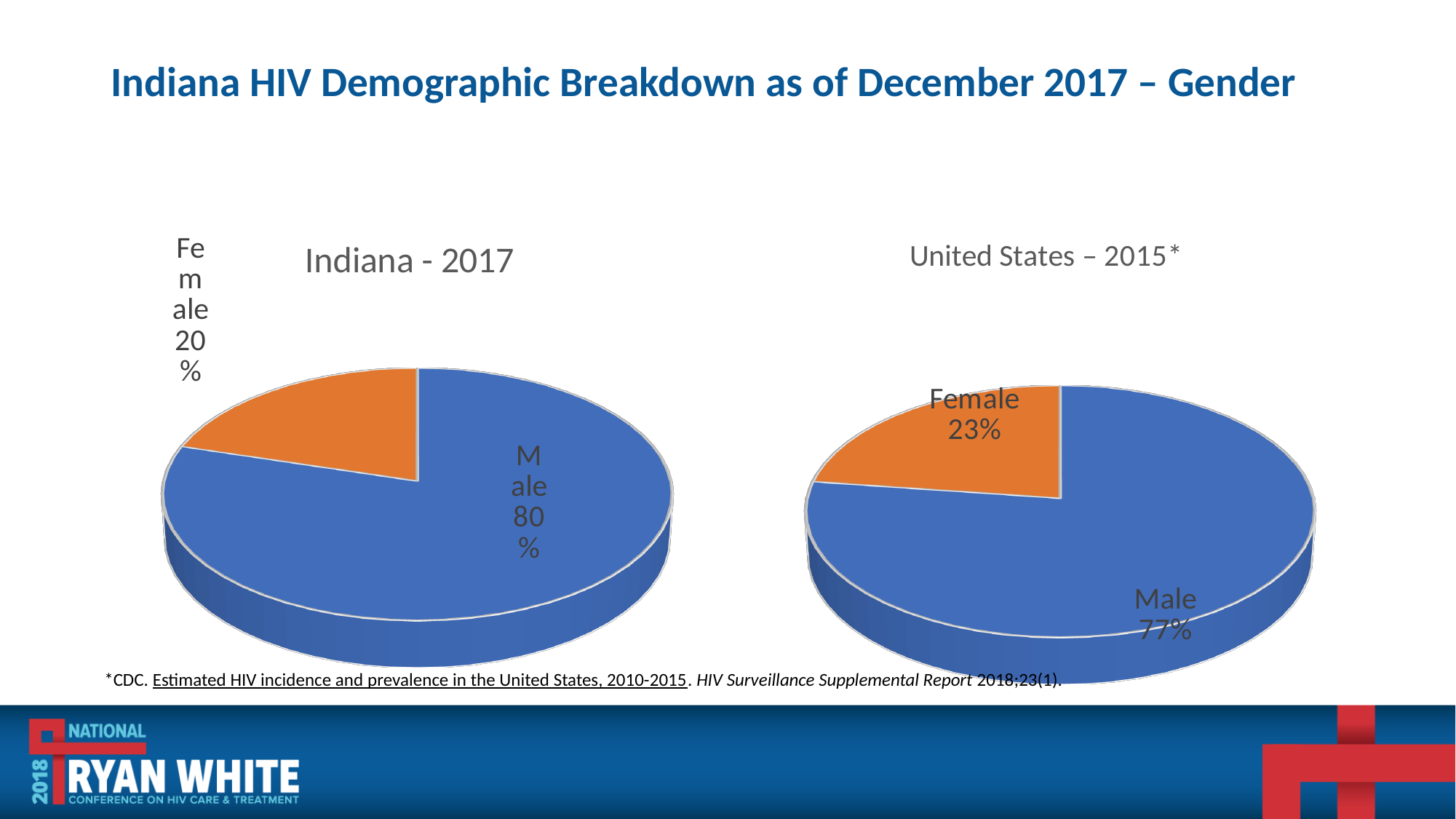
In the 'United States – 2015*' chart, which slice is the smallest? Female In the 'Indiana - 2017' chart, what colour is the Female slice? Orange In the 'Indiana - 2017' chart, what percentage is Female? 20% In the 'Indiana - 2017' chart, what is the difference between the Male and Female percentages? 60% In the 'United States – 2015*' chart, what percentage is Male? 77% In the 'United States – 2015*' chart, what is the difference between the Male and Female percentages? 54% In the 'Indiana - 2017' chart, what percentage is Male? 80% In the 'Indiana - 2017' chart, which slice is the largest? Male Which chart shows a larger Female share, 'Indiana - 2017' or 'United States – 2015*'? United States – 2015* How many slices does the 'United States – 2015*' pie chart have? 2 What type of chart is the 'Indiana - 2017' chart? Pie chart In the 'United States – 2015*' chart, what percentage is Female? 23%